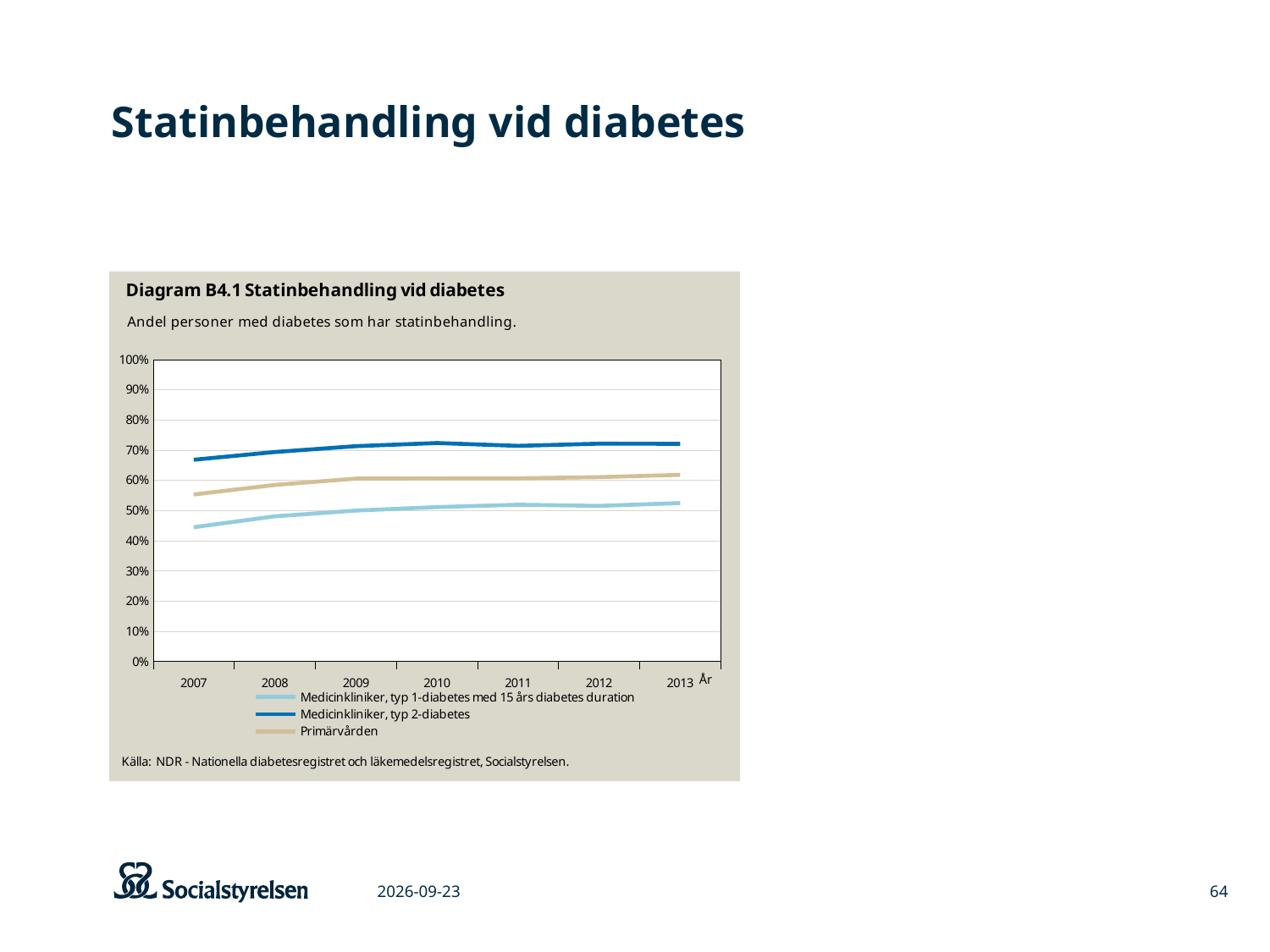
Which series has the lowest value in 2007? Medicinkliniker, typ 1-diabetes med 15 års diabetes duration What kind of chart is shown on the slide? Line chart How many series does the legend list? 3 What is the title of the chart? Diagram B4.1 Statinbehandling vid diabetes In 2010, which is larger: Primärvården or Medicinkliniker, typ 1-diabetes med 15 års diabetes duration? Primärvården Is the value for Primärvården in 2013 greater or less than 70%? less Is the value for Medicinkliniker, typ 2-diabetes in 2010 greater or less than 80%? less Does the value for Medicinkliniker, typ 1-diabetes med 15 års diabetes duration rise or fall from 2007 to 2013? rise How many years are shown along the x axis? 7 Which series has the highest value in 2013? Medicinkliniker, typ 2-diabetes Is the value for Medicinkliniker, typ 2-diabetes in 2007 greater or less than 60%? greater